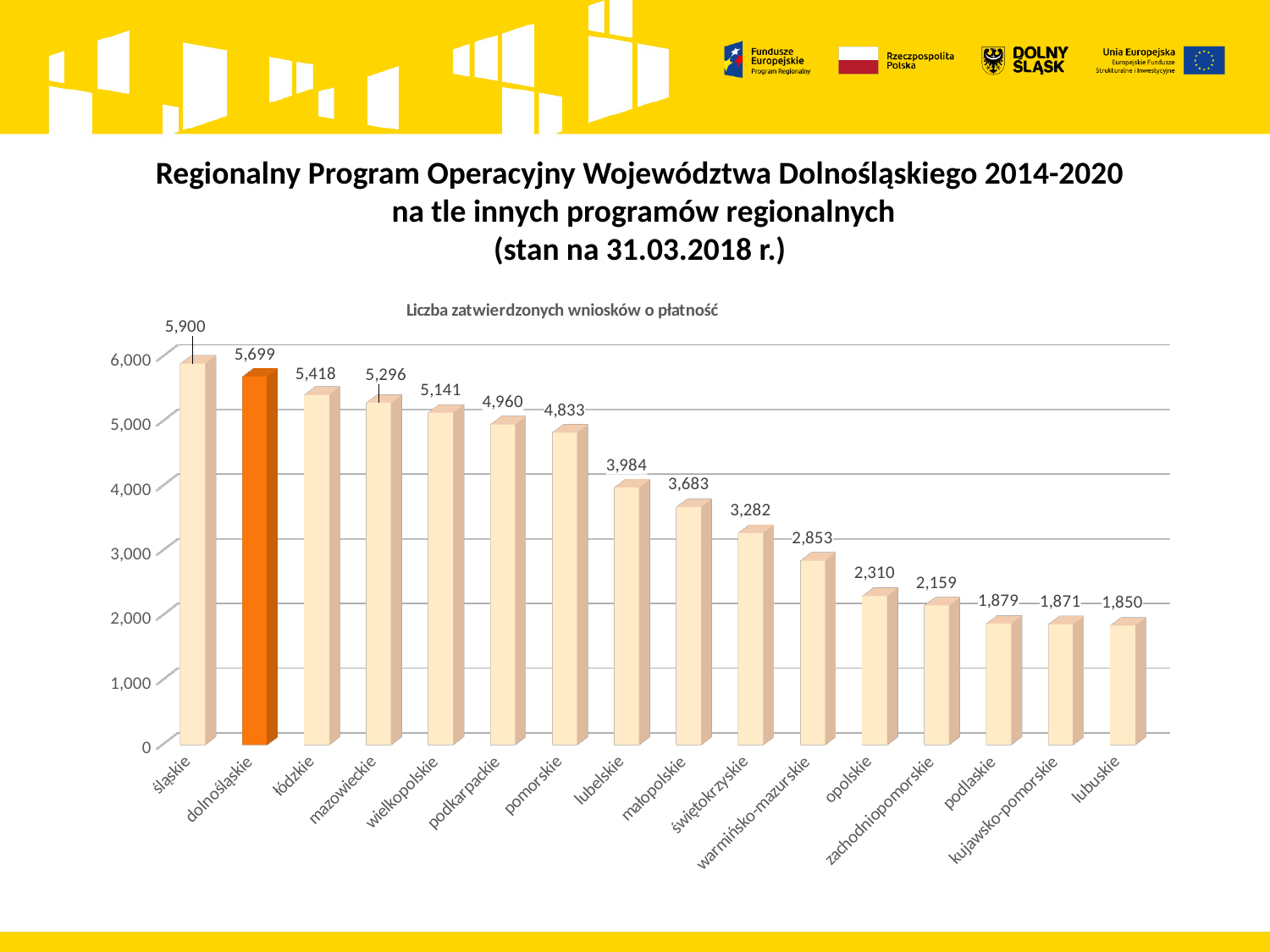
What is the value for dolnośląskie? 5,699 What is the value for warmińsko-mazurskie? 2,853 Which is larger, the value for małopolskie or the value for świętokrzyskie? małopolskie What is the difference between the values for opolskie and zachodniopomorskie? 151 What kind of chart is shown on the slide? bar chart What is the title of the chart? Liczba zatwierdzonych wniosków o płatność Is the value for pomorskie greater or less than 5,000? less Which category has the lowest value? lubuskie What is the difference between the values for śląskie and dolnośląskie? 201 How many categories are shown on the x axis? 16 Which category has the highest value? śląskie What is the value for lubelskie? 3,984